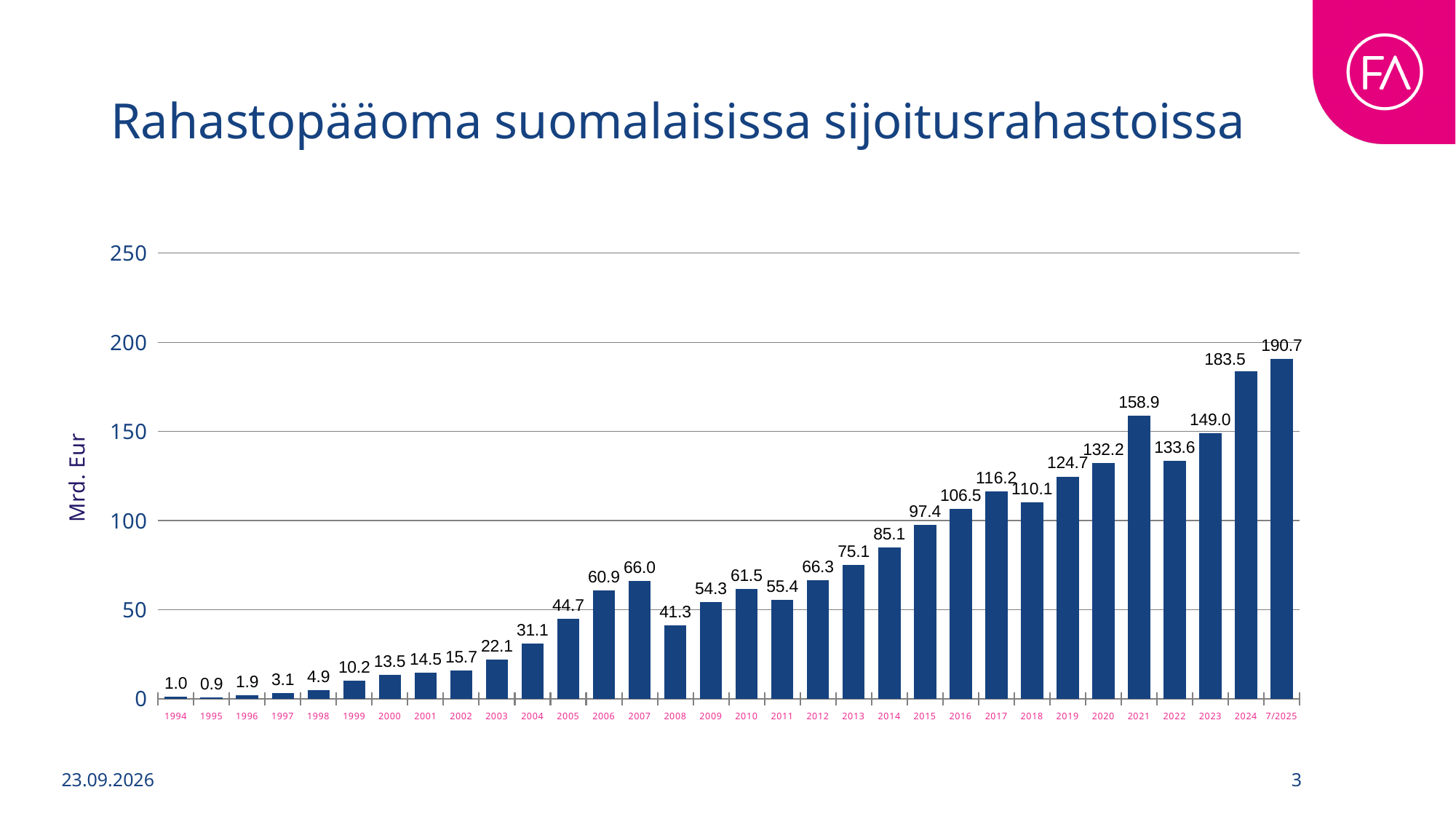
What is the value for 2021? 158.9 Which year has the lowest value? 1995 What is the difference between the values for 2024 and 2023? 34.5 Which is larger, the value for 2017 or the value for 2018? 2017 Which category has the highest value? 7/2025 What kind of chart is shown on the slide? bar chart Is the value for 2015 greater or less than 100? less Do the values generally rise or fall from 1994 to 7/2025? rise What is the value for 2008? 41.3 What is the value for 7/2025? 190.7 How many bars are shown in the chart? 32 What is the label on the vertical axis? Mrd. Eur